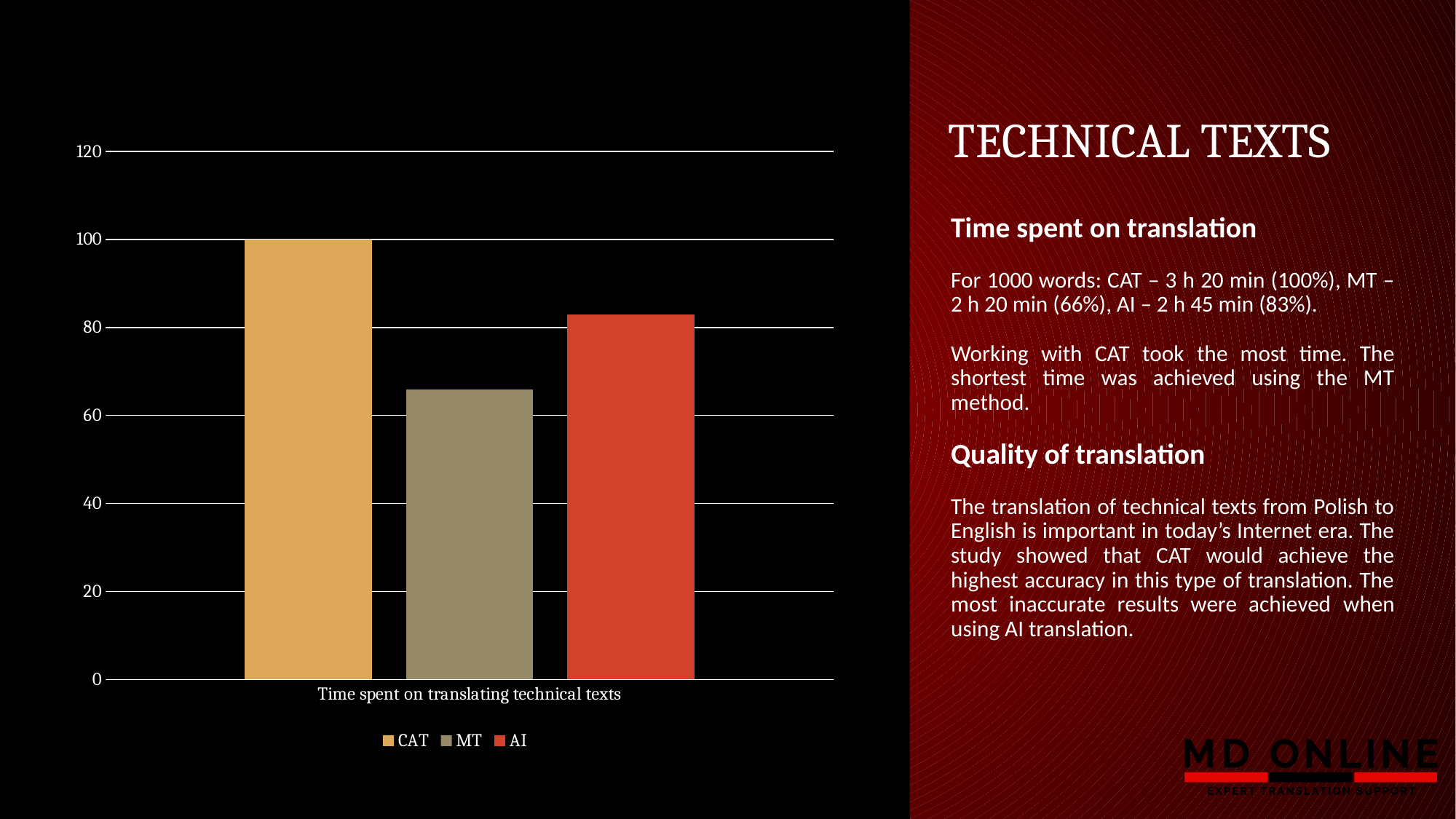
Which series has the highest bar in the chart? CAT Is the value for MT greater or less than 80? less Is the value for MT greater or less than 60? greater How many series does the chart legend list? 3 Is the value for AI greater or less than 80? greater How many categories are shown on the x axis of the chart? 1 What colour is the AI bar in the chart? red What is the value of the CAT bar in the chart? 100 Which series has the lowest bar in the chart? MT Which bar is taller in the chart, AI or MT? AI What is the category label shown on the x axis of the chart? Time spent on translating technical texts What kind of chart is shown on the slide? bar chart